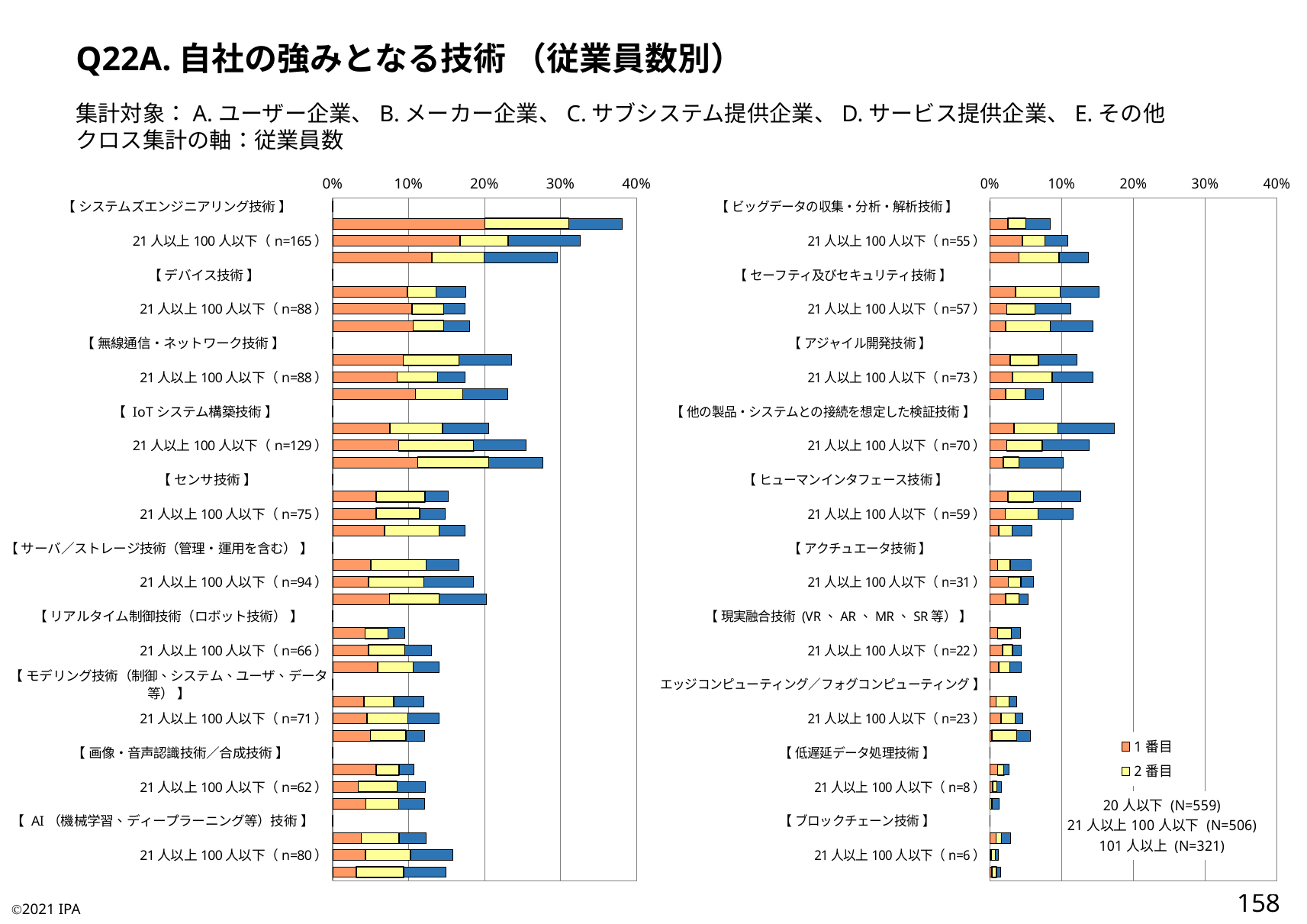
In the left chart, which technology category has the longest total bar? システムズエンジニアリング技術 In the right chart, is the total value of the first bar (20人以下) under 他の製品・システムとの接続を想定した検証技術 greater or less than 10%? greater What is the title of the slide containing the charts? Q22A. 自社の強みとなる技術（従業員数別） In the right chart, how many technology categories (bracketed headings) are listed? 10 How many series entries does the legend on the right chart list? 2 What kind of chart is shown on the left side of the slide? stacked bar chart In the right chart, is the total value of the first bar (20人以下) under ビッグデータの収集・分析・解析技術 greater or less than 10%? less What is the highest value shown on the x axis of the left chart? 40% In the left chart, is the total value of the first bar (20人以下) under デバイス技術 greater or less than 20%? less In the left chart, how many technology categories (bracketed headings) are listed? 10